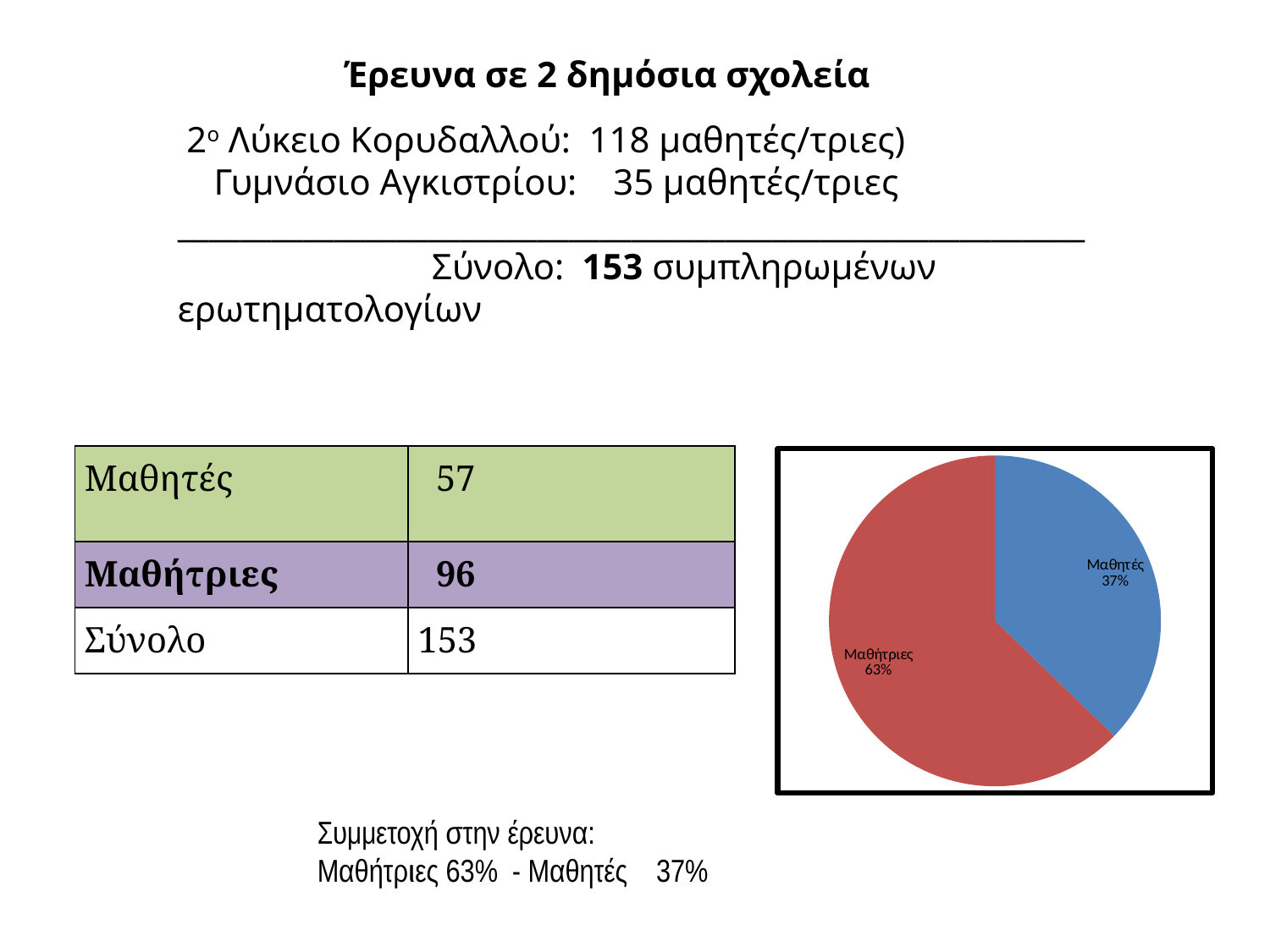
What colour is the Μαθήτριες slice of the pie chart? red Which is larger in the pie chart, Μαθητές or Μαθήτριες? Μαθήτριες What share of the pie does Μαθήτριες represent? 63% What share of the pie does Μαθητές represent? 37% Which slice of the pie chart is the largest? Μαθήτριες What colour is the Μαθητές slice of the pie chart? blue What is the difference in percentage points between the Μαθήτριες slice and the Μαθητές slice? 26 How many slices does the pie chart have? 2 Which slice of the pie chart is the smallest? Μαθητές What kind of chart is shown on the slide? pie chart